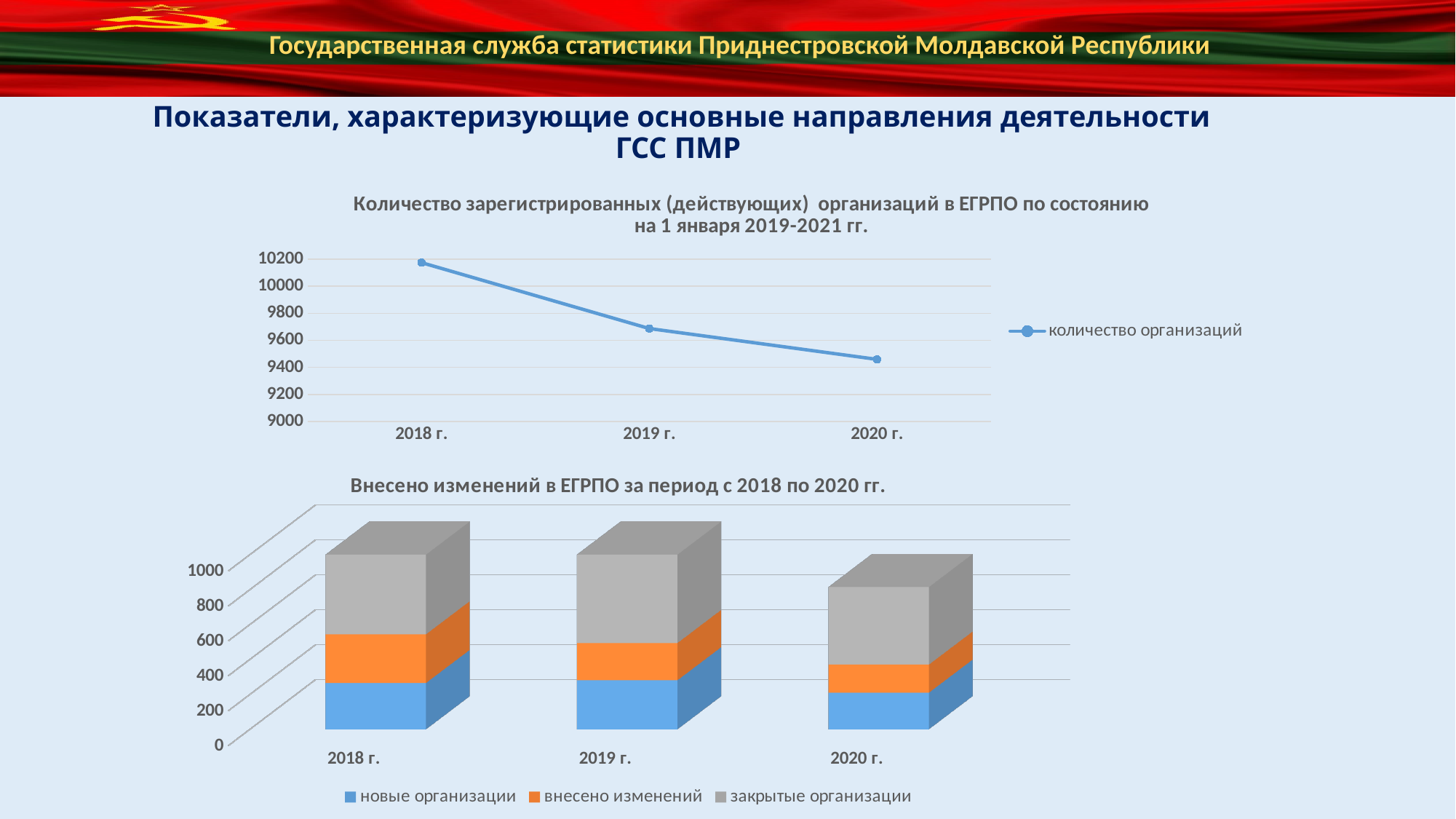
In the top line chart, is the value for 2020 г. greater or less than 9600? less How many data points are plotted in the top line chart? 3 In the bottom stacked bar chart, which year has the lowest total bar? 2020 г. In the top line chart, which year has the highest number of organisations? 2018 г. In the top line chart, which year has the lowest number of organisations? 2020 г. In the top line chart, is the value for 2019 г. greater or less than 9800? less In the top line chart, is the value for 2018 г. greater or less than 10000? greater What kind of chart is the bottom chart, 'Внесено изменений в ЕГРПО за период с 2018 по 2020 гг.'? stacked bar chart How many series does the legend of the bottom stacked bar chart list? 3 In the bottom stacked bar chart, which series is shown in grey? закрытые организации In the top line chart, do the values rise or fall from 2018 to 2020? fall What kind of chart is the top chart, 'Количество зарегистрированных (действующих) организаций в ЕГРПО'? line chart